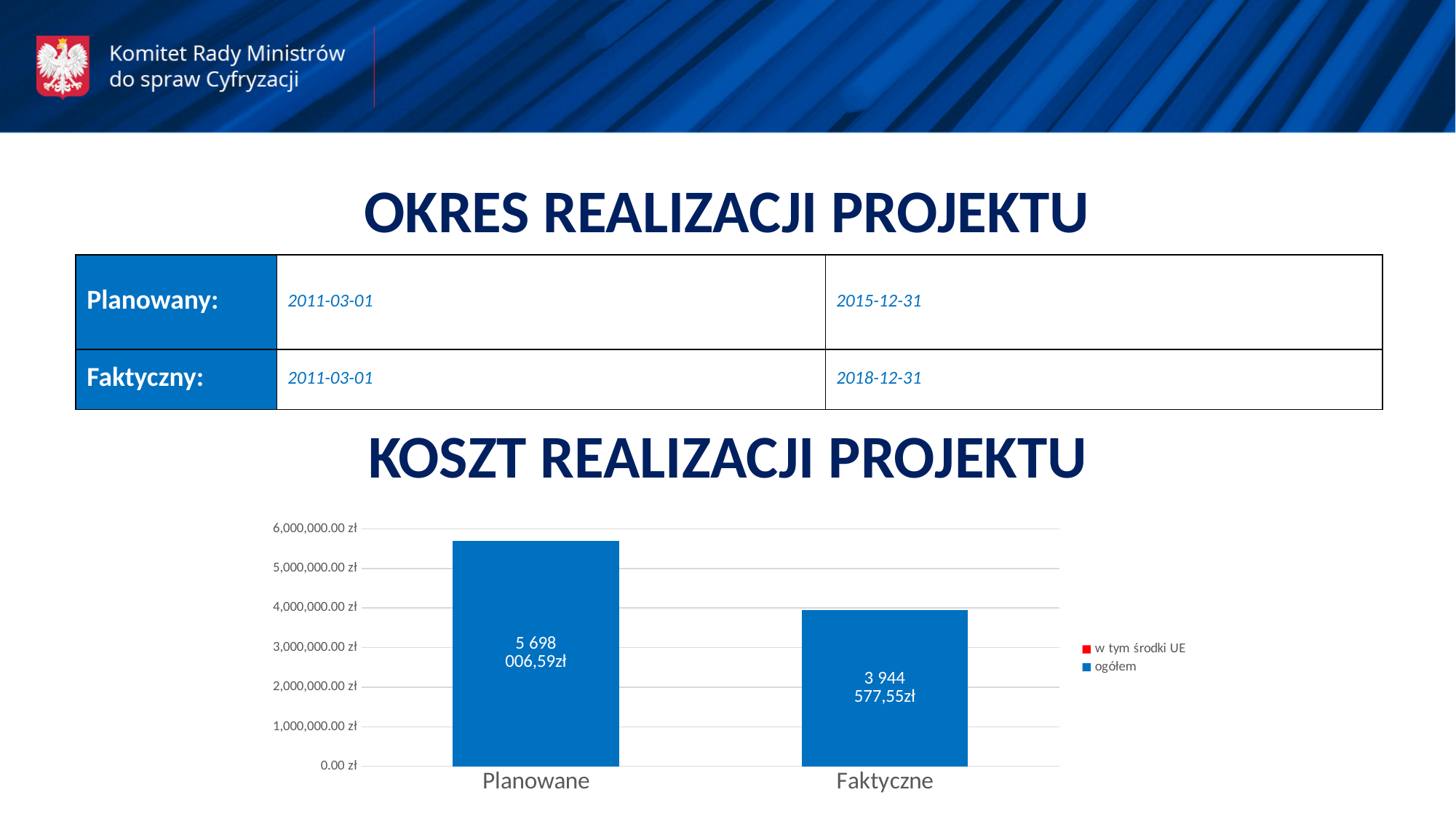
What type of chart is shown under KOSZT REALIZACJI PROJEKTU? bar chart Is the value for Faktyczne greater or less than 4,000,000.00 zł? less How many categories are shown on the x axis of the KOSZT REALIZACJI PROJEKTU chart? 2 Which legend entry in the KOSZT REALIZACJI PROJEKTU chart is shown in blue? ogółem What is the value of the Faktyczne bar in the KOSZT REALIZACJI PROJEKTU chart? 3 944 577,55zł What is the value of the Planowane bar in the KOSZT REALIZACJI PROJEKTU chart? 5 698 006,59zł What is the difference between the Planowane and Faktyczne values in the KOSZT REALIZACJI PROJEKTU chart? 1 753 429,04zł Which category has the higher value in the KOSZT REALIZACJI PROJEKTU chart? Planowane Is the Planowane value larger or smaller than the Faktyczne value in the KOSZT REALIZACJI PROJEKTU chart? larger How many series does the legend of the KOSZT REALIZACJI PROJEKTU chart list? 2 Is the value for Planowane greater or less than 5,000,000.00 zł? greater Which category has the lower value in the KOSZT REALIZACJI PROJEKTU chart? Faktyczne